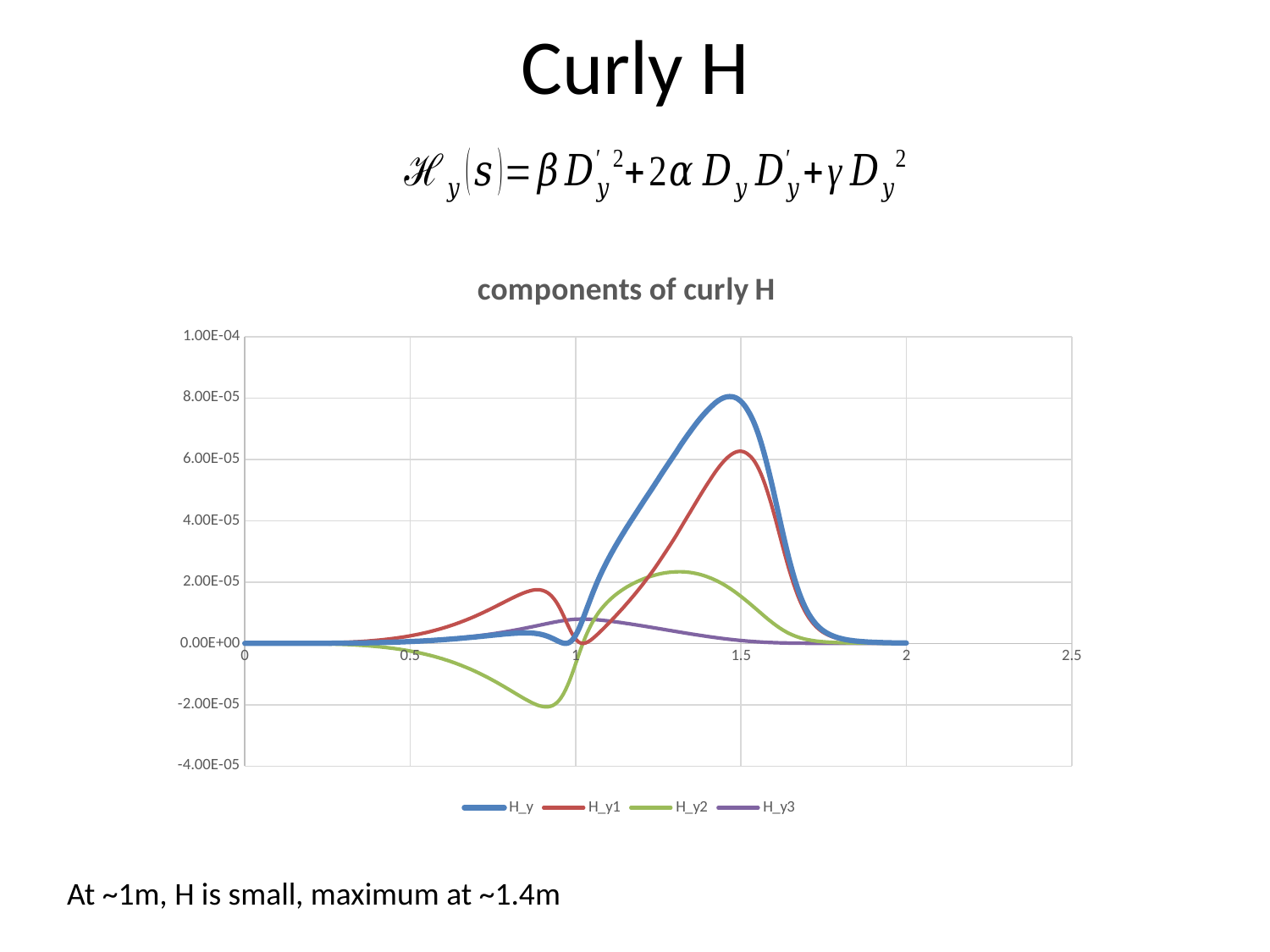
How many series does the legend of the chart list? 4 Is the peak value of H_y1 greater or less than 8.00E-05? less What kind of chart is shown on the slide? line chart Which series reaches the highest peak value on the chart? H_y Which series is drawn with the thick blue line? H_y Is the minimum value of H_y2 greater or less than 0.00E+00? less Is the peak value of H_y1 greater or less than 4.00E-05? greater Which series dips to the lowest (most negative) value on the chart? H_y2 Which series has the larger peak value, H_y1 or H_y2? H_y1 What is the title of the chart? components of curly H